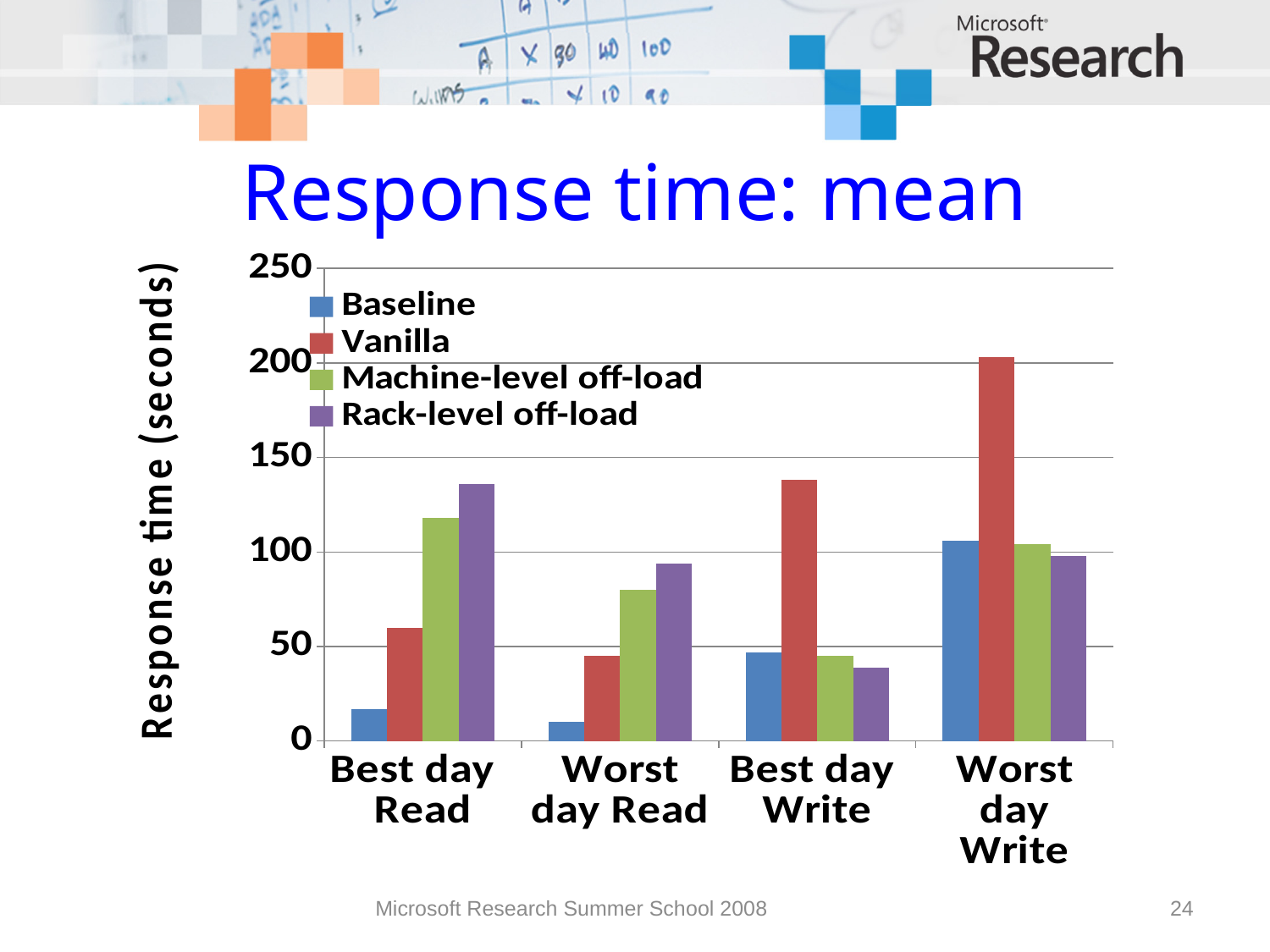
Which series has the highest value for Best day Read? Rack-level off-load Which series has the lowest value for Worst day Read? Baseline Is the Baseline value for Best day Read greater or less than 50? less How many categories are shown on the x axis? 4 Is the Rack-level off-load value for Worst day Read greater or less than 100? less For Best day Read, which is larger: Rack-level off-load or Machine-level off-load? Rack-level off-load How many series does the legend list? 4 For Best day Write, which is larger: Vanilla or Baseline? Vanilla What is the label of the y axis? Response time (seconds) For which category is the Vanilla bar the highest? Worst day Write What kind of chart is shown on the slide? bar chart Is the Vanilla value for Worst day Write greater or less than 150? greater